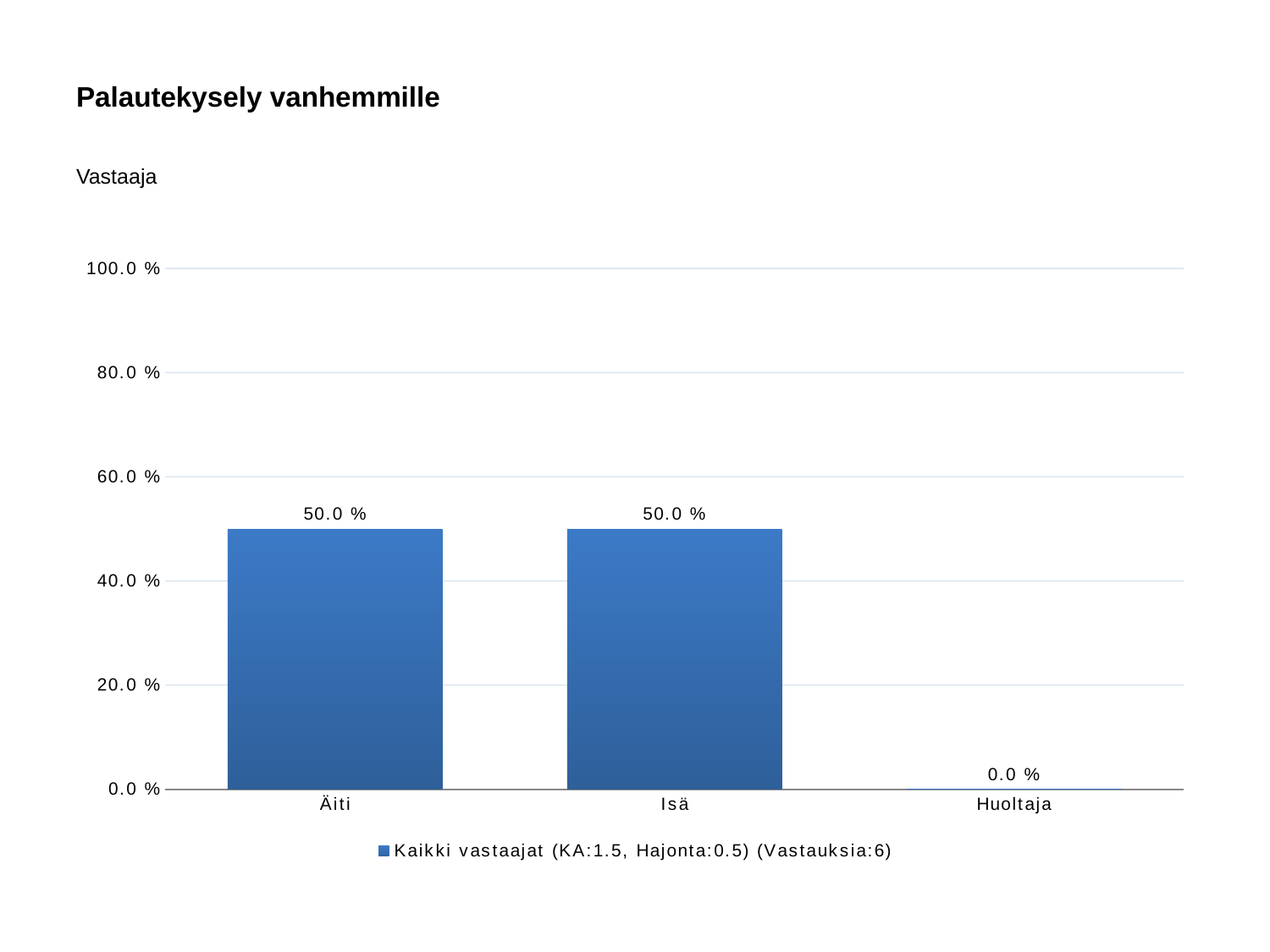
Which category has the lowest value? Huoltaja What is the value for Huoltaja? 0.0 % What is the difference between the values for Äiti and Huoltaja? 50.0 % What kind of chart is shown? bar chart How many categories are shown on the x axis? 3 What is the value for Äiti? 50.0 % What is the title of the chart? Vastaaja What is the legend entry for the series? Kaikki vastaajat (KA:1.5, Hajonta:0.5) (Vastauksia:6) What is the value for Isä? 50.0 % Is the value for Äiti greater or less than 40.0 %? greater Which is larger, the value for Isä or the value for Huoltaja? Isä How many series does the legend list? 1